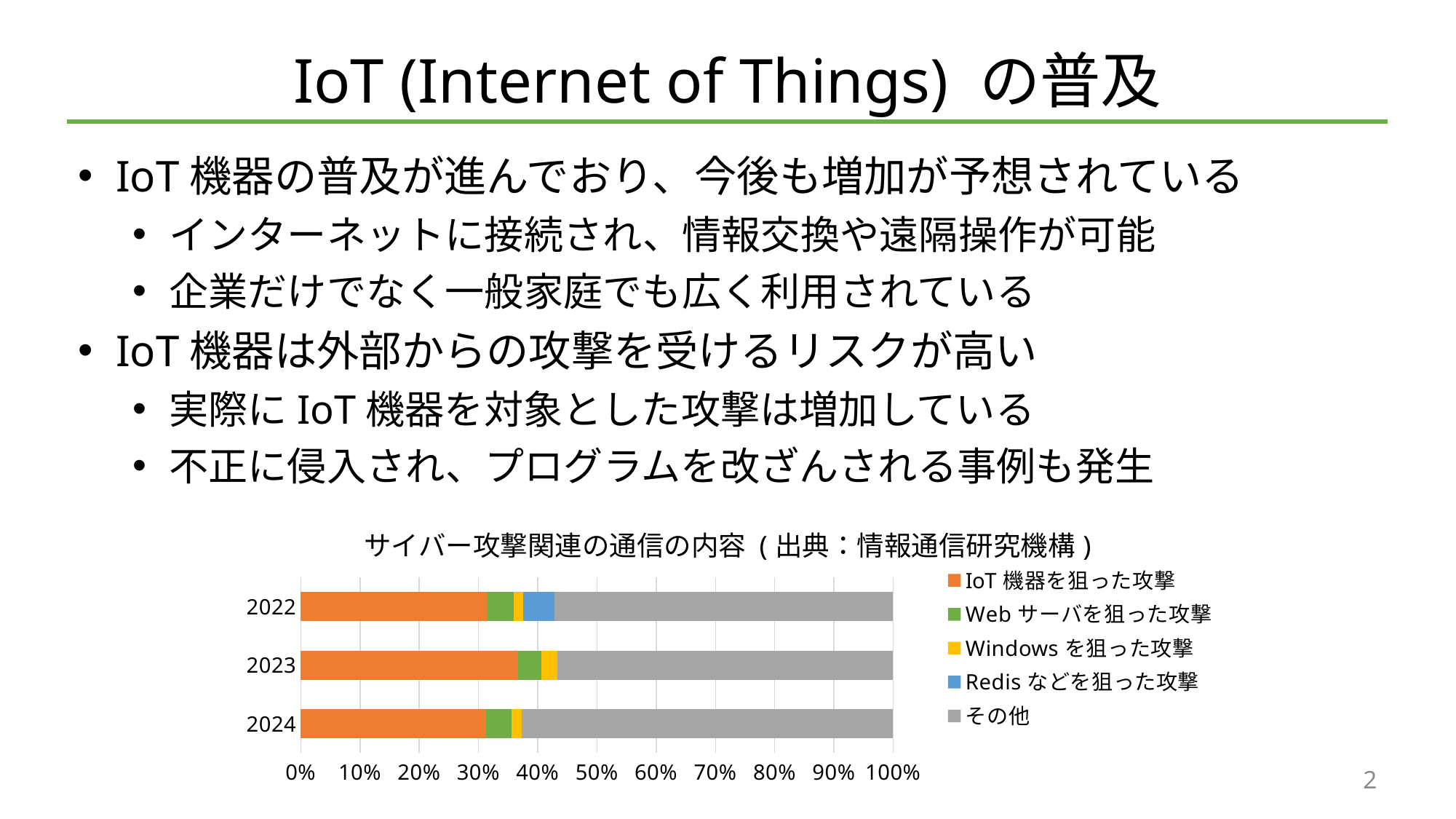
Which legend entry is shown in orange? IoT 機器を狙った攻撃 In which year is the Redis などを狙った攻撃 segment clearly visible in the chart? 2022 Is the share of その他 in 2022 greater or less than 50%? greater What is the title of the chart? サイバー攻撃関連の通信の内容（出典：情報通信研究機構） Is the share of IoT 機器を狙った攻撃 in 2023 greater or less than 40%? less In which year is the share of IoT 機器を狙った攻撃 the largest? 2023 How many series does the chart legend list? 5 How many years (categories) are plotted in the chart? 3 Is the share of IoT 機器を狙った攻撃 in 2023 greater or less than 30%? greater What kind of chart is shown on the slide? stacked bar chart Which is larger: the share of IoT 機器を狙った攻撃 in 2023 or in 2022? 2023